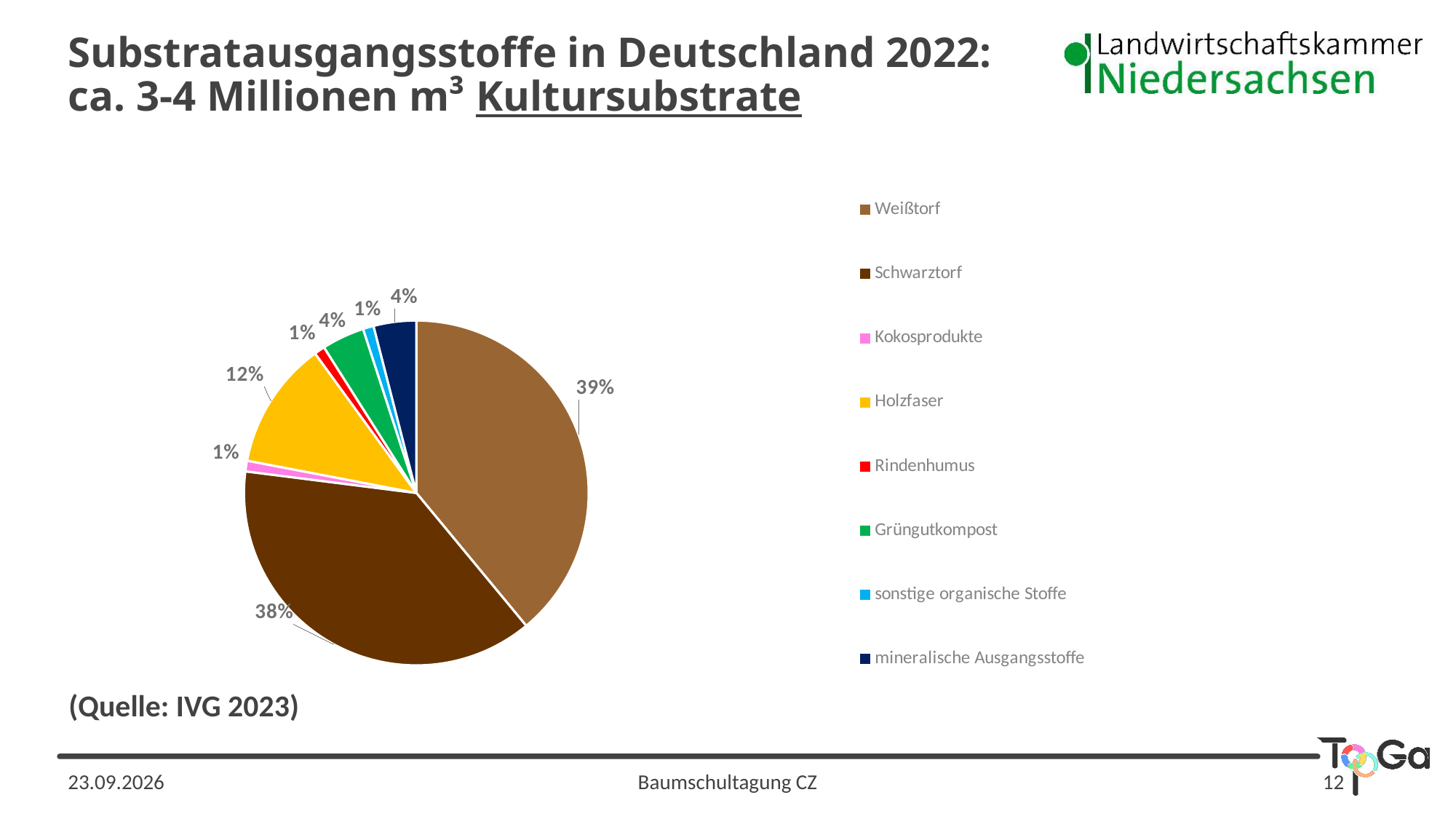
Which has the larger share, Holzfaser or Grüngutkompost? Holzfaser What percentage is shown for Grüngutkompost? 4% What percentage is shown for Holzfaser? 12% How many categories does the pie chart show? 8 What kind of chart is shown on the slide? Pie chart What percentage is shown for Kokosprodukte? 1% What share of the pie does Weißtorf account for? 39% Which category has the largest share of the pie? Weißtorf What colour is the Rindenhumus slice in the legend? Red What percentage is shown for mineralische Ausgangsstoffe? 4% What percentage is shown for Schwarztorf? 38% What is the difference in percentage points between Weißtorf and Holzfaser? 27